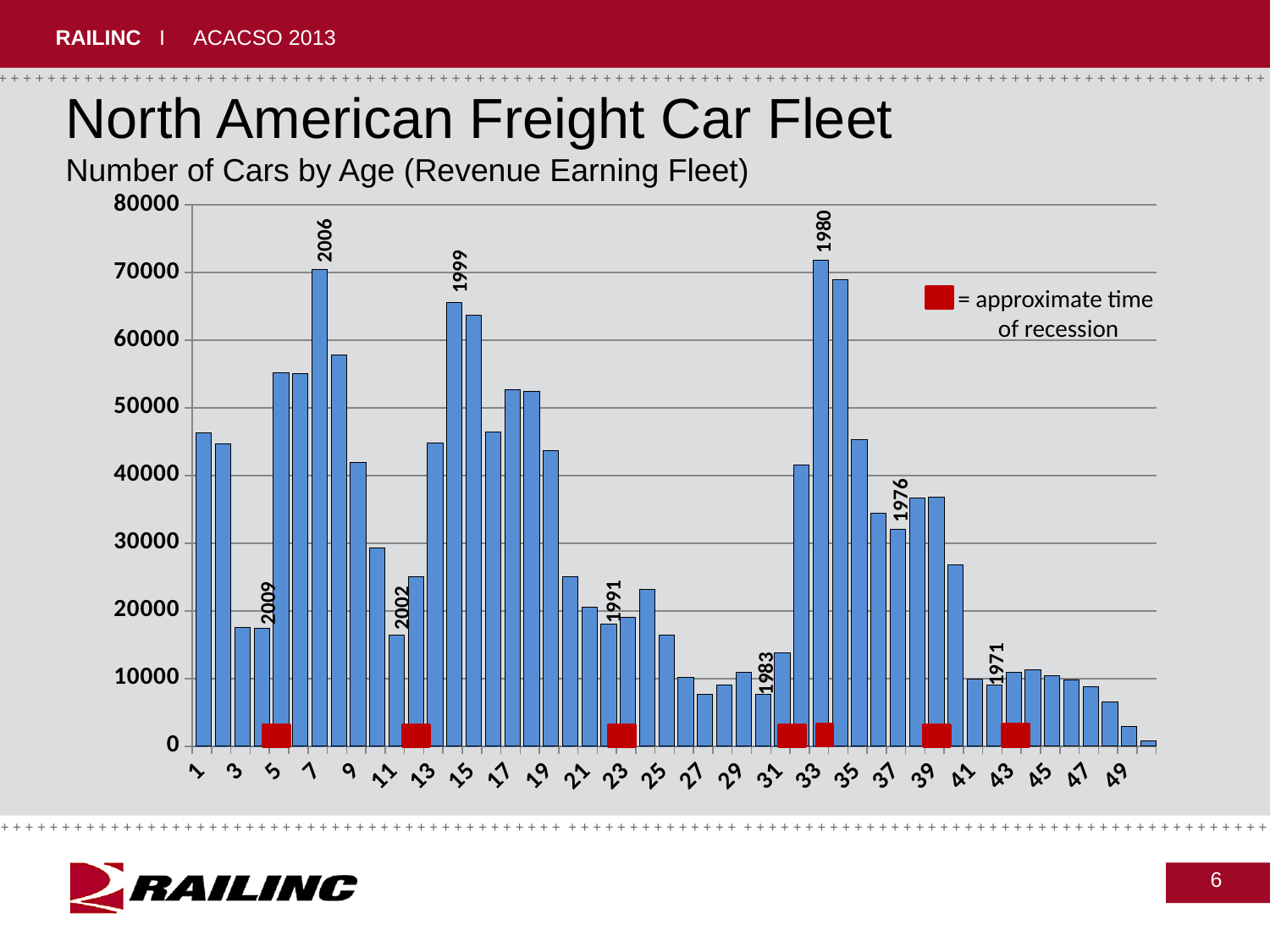
What is the title of the chart on the slide? North American Freight Car Fleet Do the values rise or fall from age 33 to age 41? fall Is the value for age 3 greater or less than 20000? less Is the value for age 40 greater or less than 30000? less Which has the larger value, age 7 (labelled 2006) or age 14 (labelled 1999)? age 7 Is the value for age 14 (labelled 1999) greater or less than 60000? greater Which has the larger value, age 1 or age 3? age 1 What kind of chart is shown on the slide? bar chart How many red recession markers are shown along the bottom of the chart? 7 According to the legend, what do the red markers on the chart indicate? approximate time of recession